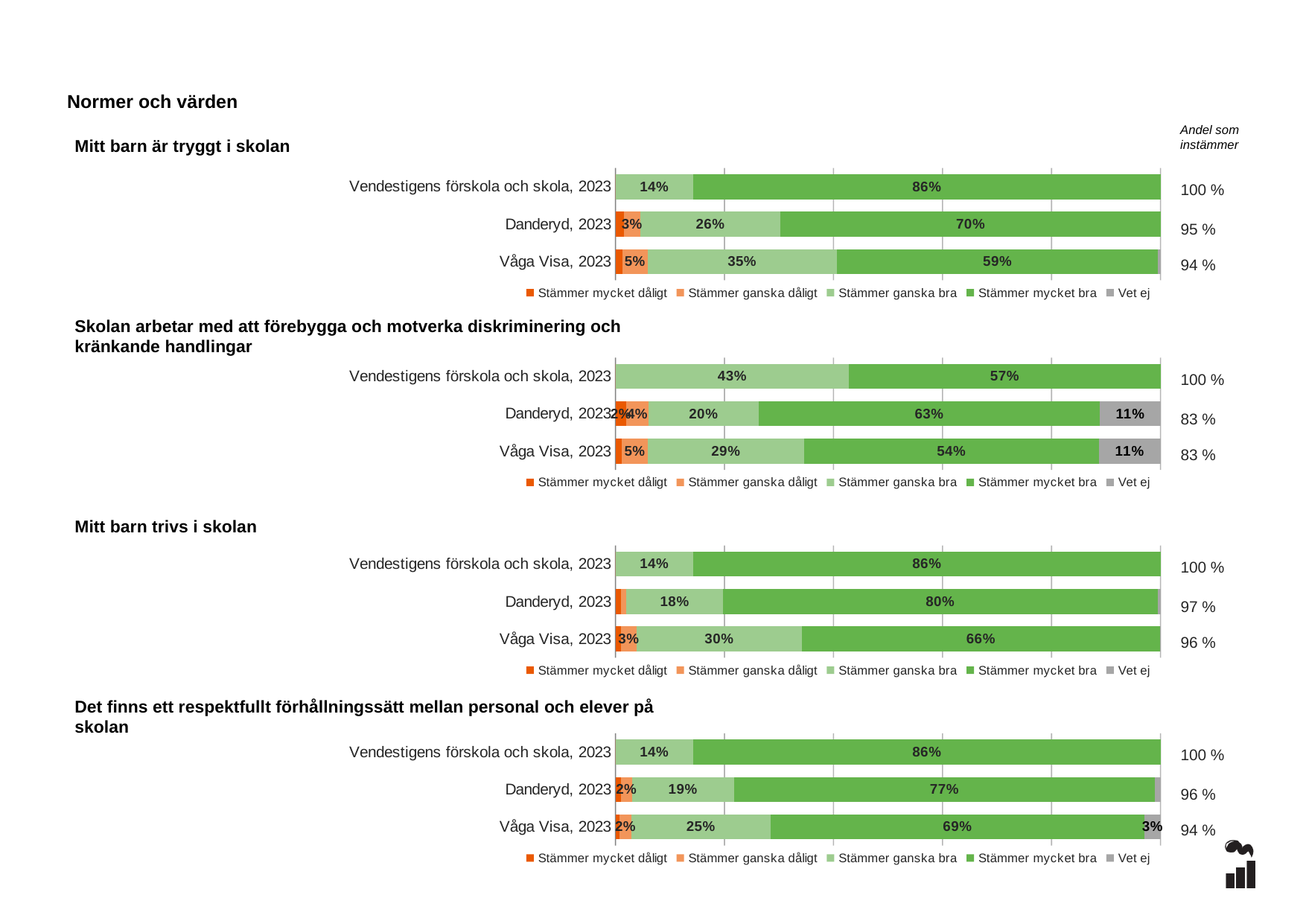
In the chart 'Det finns ett respektfullt förhållningssätt mellan personal och elever på skolan', what is the difference between the 'Stämmer ganska bra' values for Våga Visa, 2023 and Danderyd, 2023? 6% In the chart 'Skolan arbetar med att förebygga och motverka diskriminering och kränkande handlingar', which category has the lowest 'Stämmer ganska bra' value? Danderyd, 2023 In the chart 'Mitt barn är tryggt i skolan', which category has the highest 'Stämmer mycket bra' value? Vendestigens förskola och skola, 2023 In the chart 'Skolan arbetar med att förebygga och motverka diskriminering och kränkande handlingar', what is the difference between the 'Stämmer mycket bra' values for Danderyd, 2023 and Våga Visa, 2023? 9% In the chart 'Mitt barn trivs i skolan', what is the 'Stämmer mycket bra' value for Danderyd, 2023? 80% In the chart 'Mitt barn är tryggt i skolan', what is the 'Stämmer mycket bra' value for Vendestigens förskola och skola, 2023? 86% In the chart 'Mitt barn är tryggt i skolan', what is the 'Stämmer ganska bra' value for Våga Visa, 2023? 35% How many series does the legend of the chart 'Mitt barn trivs i skolan' list? 5 In the chart 'Det finns ett respektfullt förhållningssätt mellan personal och elever på skolan', what is the 'Stämmer mycket bra' value for Våga Visa, 2023? 69% What kind of chart is 'Mitt barn är tryggt i skolan'? Stacked bar chart In the chart 'Skolan arbetar med att förebygga och motverka diskriminering och kränkande handlingar', what is the 'Vet ej' value for Danderyd, 2023? 11% In the chart 'Mitt barn trivs i skolan', is the 'Stämmer mycket bra' value larger for Danderyd, 2023 or Våga Visa, 2023? Danderyd, 2023